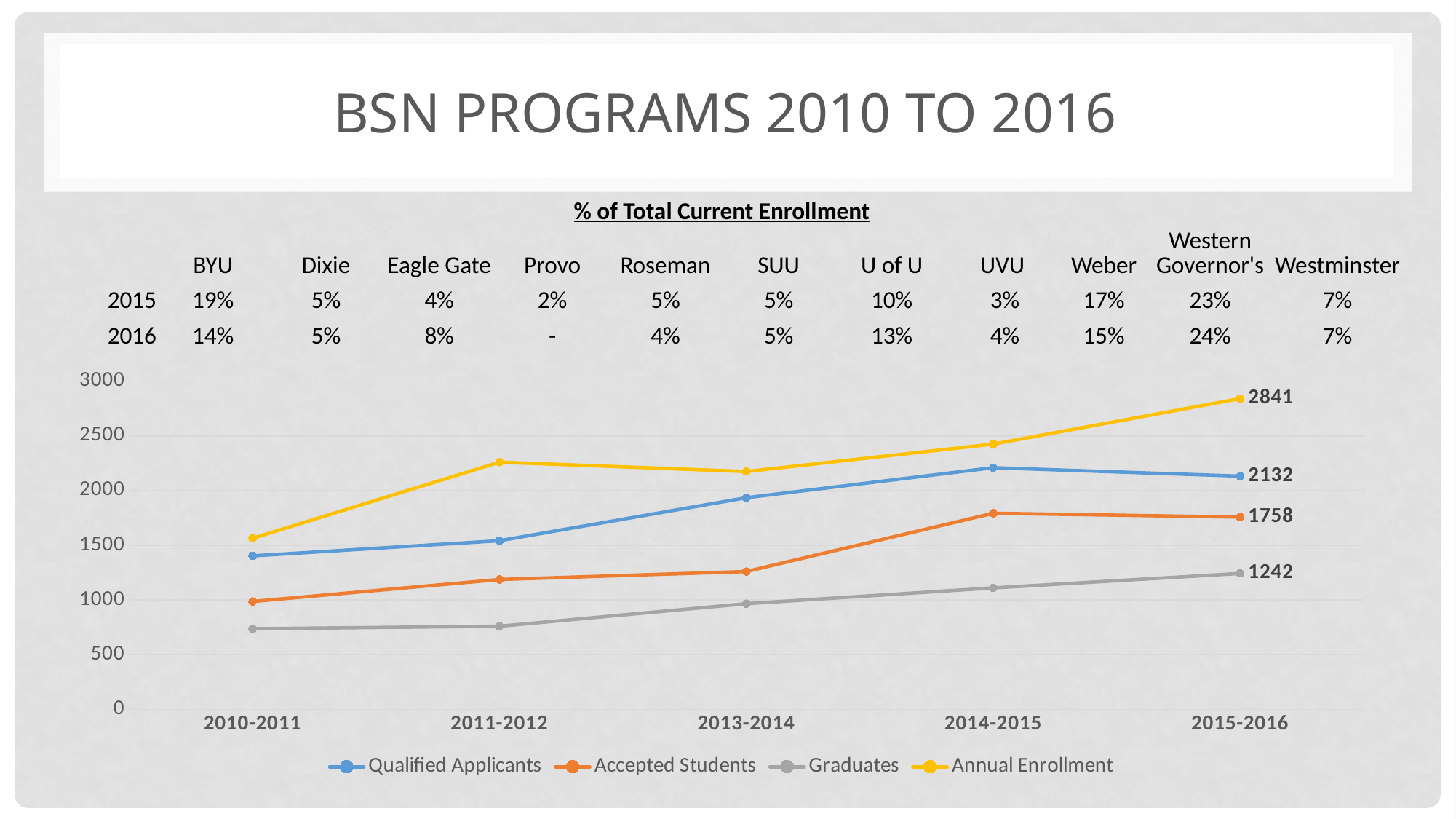
How many series does the legend list? 4 What kind of chart is shown on the slide? Line chart What is the value for Graduates in 2015-2016? 1242 What is the value for Annual Enrollment in 2015-2016? 2841 What is the value for Qualified Applicants in 2015-2016? 2132 What is the difference between Annual Enrollment and Qualified Applicants in 2015-2016? 709 Which series has the lowest value in 2015-2016? Graduates Does the Graduates series rise or fall from 2010-2011 to 2015-2016? Rise Which series has the highest value in 2015-2016? Annual Enrollment How many time periods are shown on the x axis? 5 Is the value for Graduates in 2010-2011 greater or less than 1000? less What is the difference between Accepted Students and Graduates in 2015-2016? 516